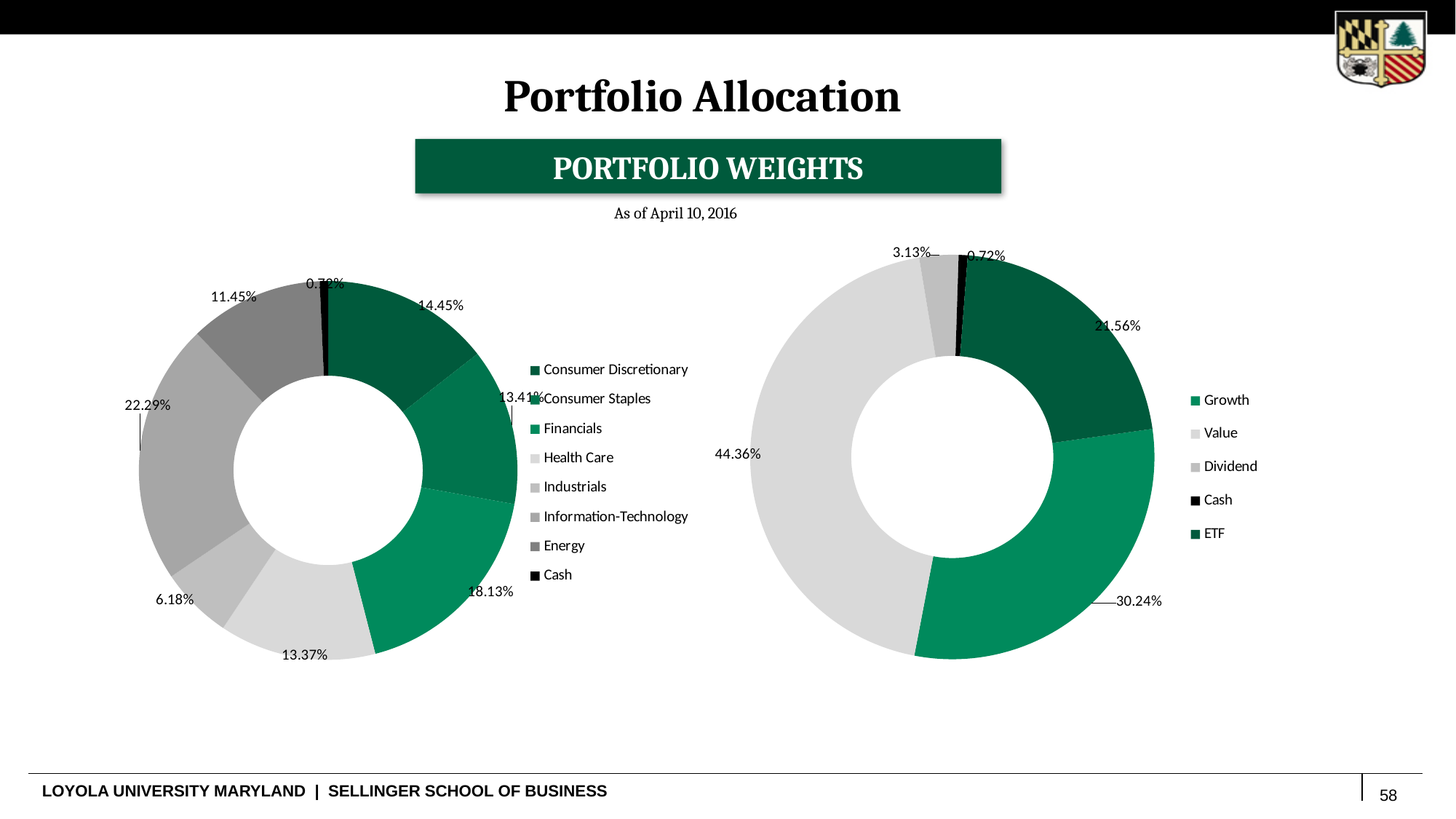
What date is shown under the Portfolio Weights heading? As of April 10, 2016 In the left chart (sector weights), how many categories does the legend list? 8 In the right chart (style weights), what is the value for ETF? 21.56% In the left chart (sector weights), which category has the largest share? Information-Technology In the left chart (sector weights), what is the difference between Information-Technology and Energy? 10.84% In the left chart (sector weights), what is the value for Financials? 18.13% What kind of chart is the right chart (style weights)? Doughnut (pie) chart In the right chart (style weights), what is the difference between Value and Growth? 14.12% In the left chart (sector weights), what is the value for Information-Technology? 22.29% In the right chart (style weights), what is the value for Value? 44.36% In the right chart (style weights), which is larger, Growth or ETF? Growth In the left chart (sector weights), which category has the smallest share? Cash